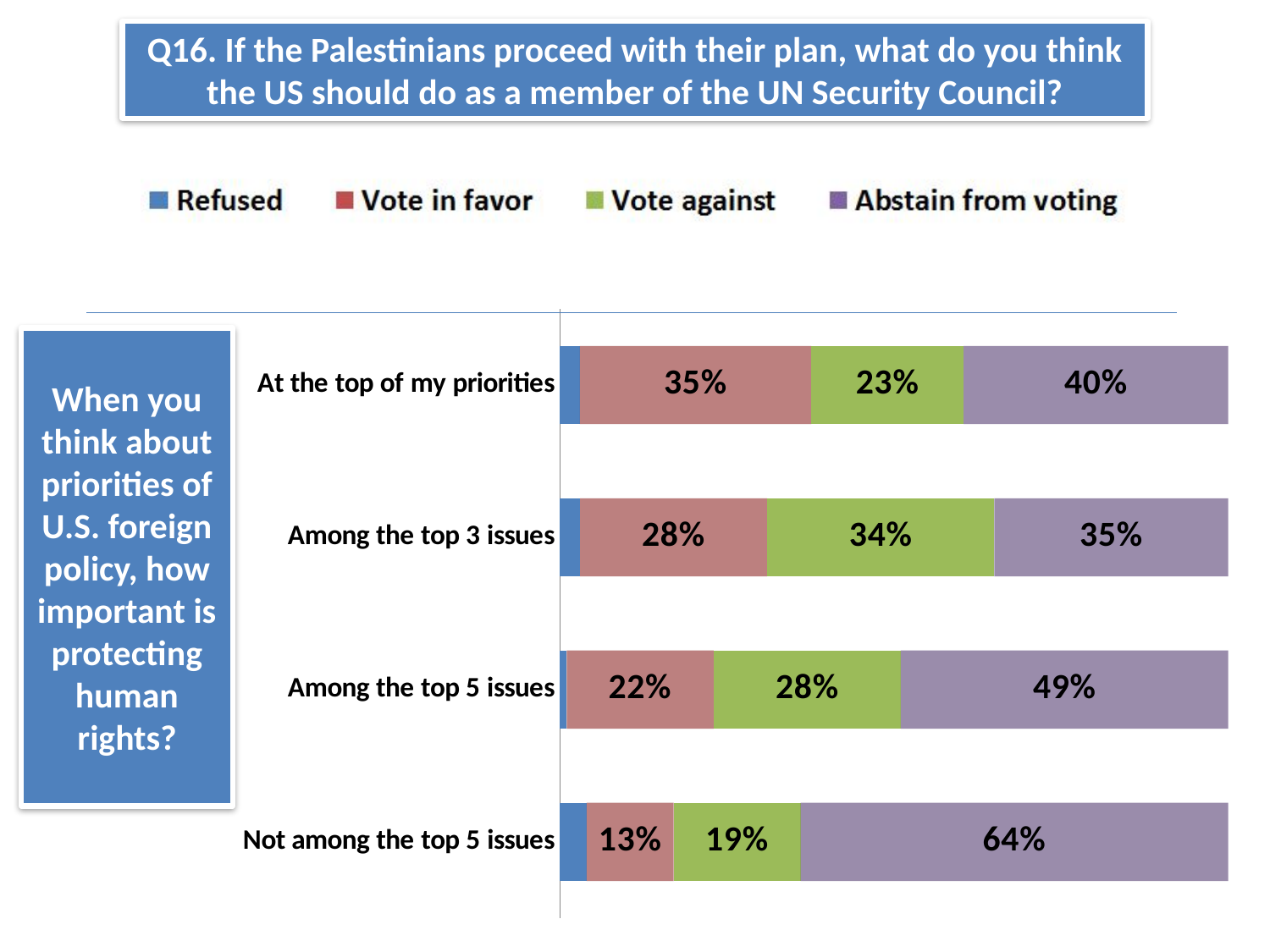
Which category has the highest 'Abstain from voting' value? Not among the top 5 issues Which category has the lowest 'Vote in favor' value? Not among the top 5 issues How many series does the legend list? 4 Which series is shown in green in the legend? Vote against What is the 'Abstain from voting' value for the 'Not among the top 5 issues' category? 64% How many categories are shown on the chart? 4 What kind of chart is shown on the slide? Stacked bar chart What is the 'Abstain from voting' value for the 'Among the top 5 issues' category? 49% What is the 'Vote against' value for the 'Among the top 3 issues' category? 34% For the 'Among the top 3 issues' category, which is larger: 'Vote in favor' or 'Vote against'? Vote against What percentage of respondents who rank human rights 'At the top of my priorities' say the US should vote in favor? 35% What is the difference between the 'Abstain from voting' values for 'Not among the top 5 issues' and 'At the top of my priorities'? 24 percentage points